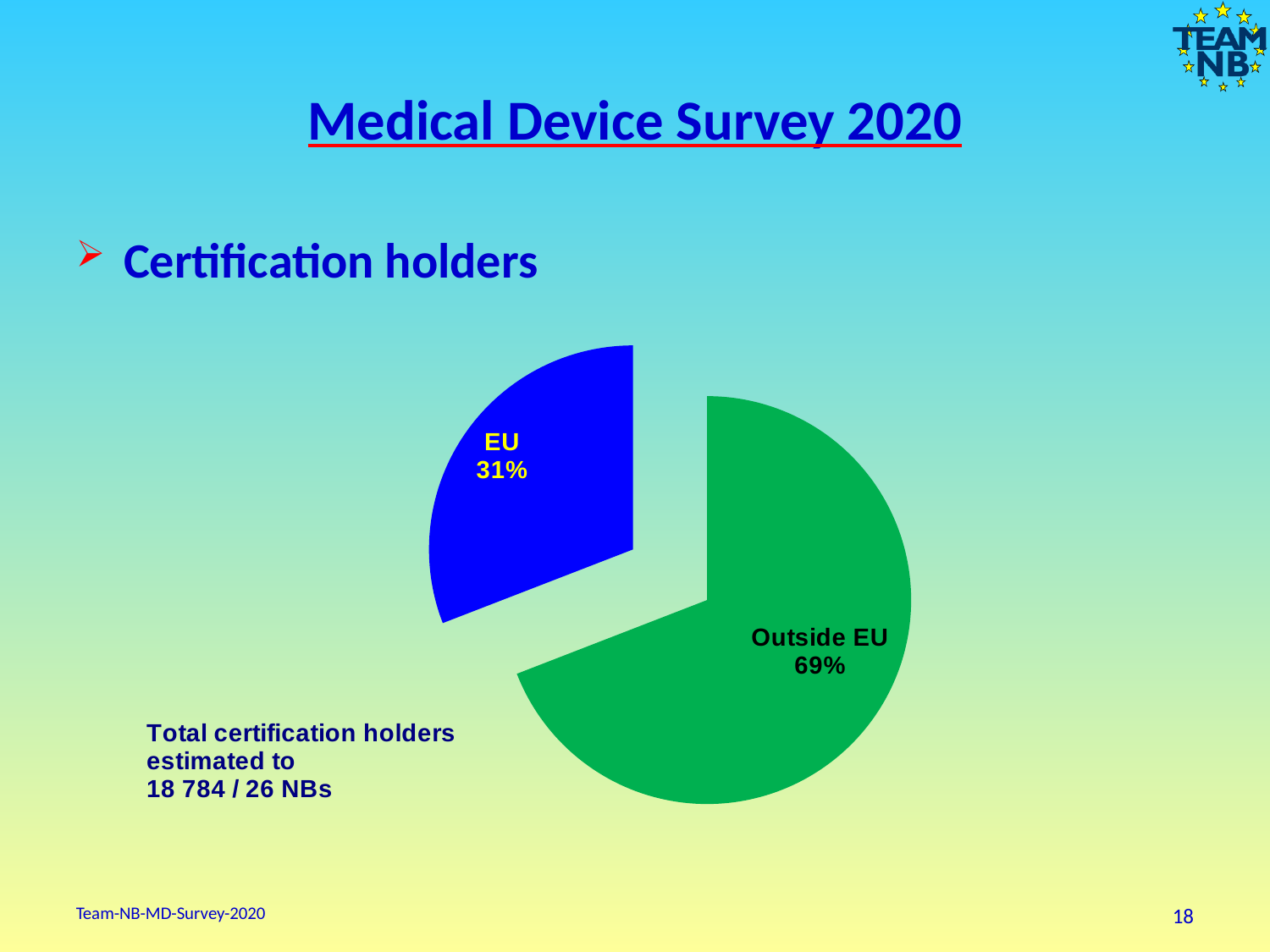
What colour is the EU slice of the pie chart? Blue How many slices does the pie chart have? 2 Which is larger, the EU slice or the Outside EU slice? Outside EU What colour is the Outside EU slice of the pie chart? Green What share of certification holders are from the EU? 31% What share of certification holders are from outside the EU? 69% What is the difference in percentage points between the Outside EU and EU slices? 38 Which slice of the pie chart is the smallest? EU What is the total number of certification holders estimated to, according to the text next to the chart? 18 784 / 26 NBs Which slice of the pie chart is the largest? Outside EU What kind of chart is shown on the slide? Pie chart